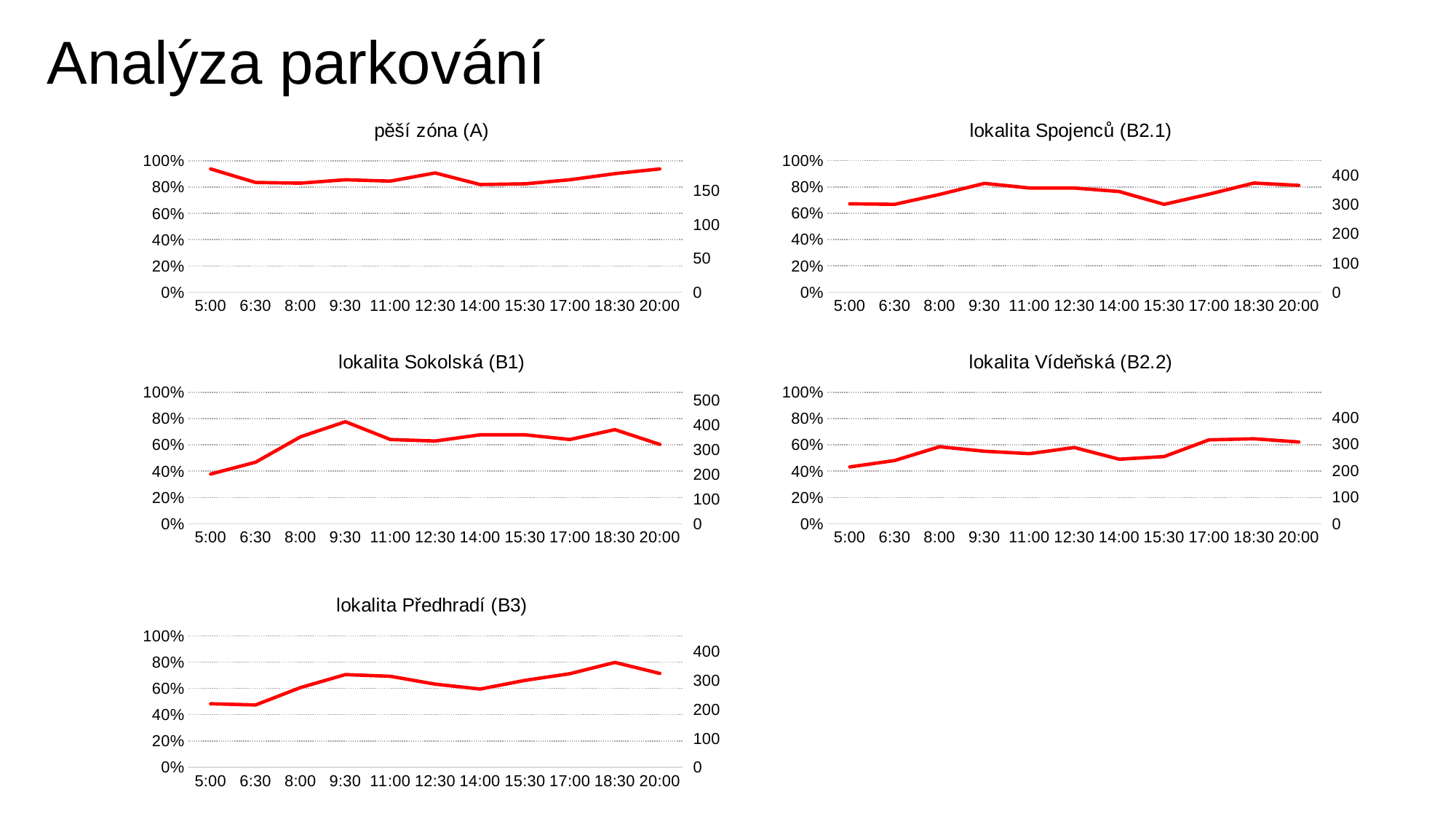
In the "pěší zóna (A)" chart, is the value at 5:00 greater or less than 80%? greater In the "lokalita Sokolská (B1)" chart, does the value rise or fall from 5:00 to 9:30? rise In the "lokalita Vídeňská (B2.2)" chart, at which time is the value lowest? 5:00 How many charts are shown on the slide? 5 In the "lokalita Sokolská (B1)" chart, which is larger: the value at 5:00 or the value at 9:30? 9:30 What kind of chart is "pěší zóna (A)"? line chart In the "lokalita Vídeňská (B2.2)" chart, is the value at 5:00 greater or less than 60%? less How many time points are plotted along the x axis of the "lokalita Sokolská (B1)" chart? 11 In the "lokalita Předhradí (B3)" chart, at which time is the value highest? 18:30 In the "lokalita Sokolská (B1)" chart, at which time is the value highest? 9:30 In the "lokalita Spojenců (B2.1)" chart, is the value at 15:30 greater or less than 80%? less In the "lokalita Sokolská (B1)" chart, at which time is the value lowest? 5:00